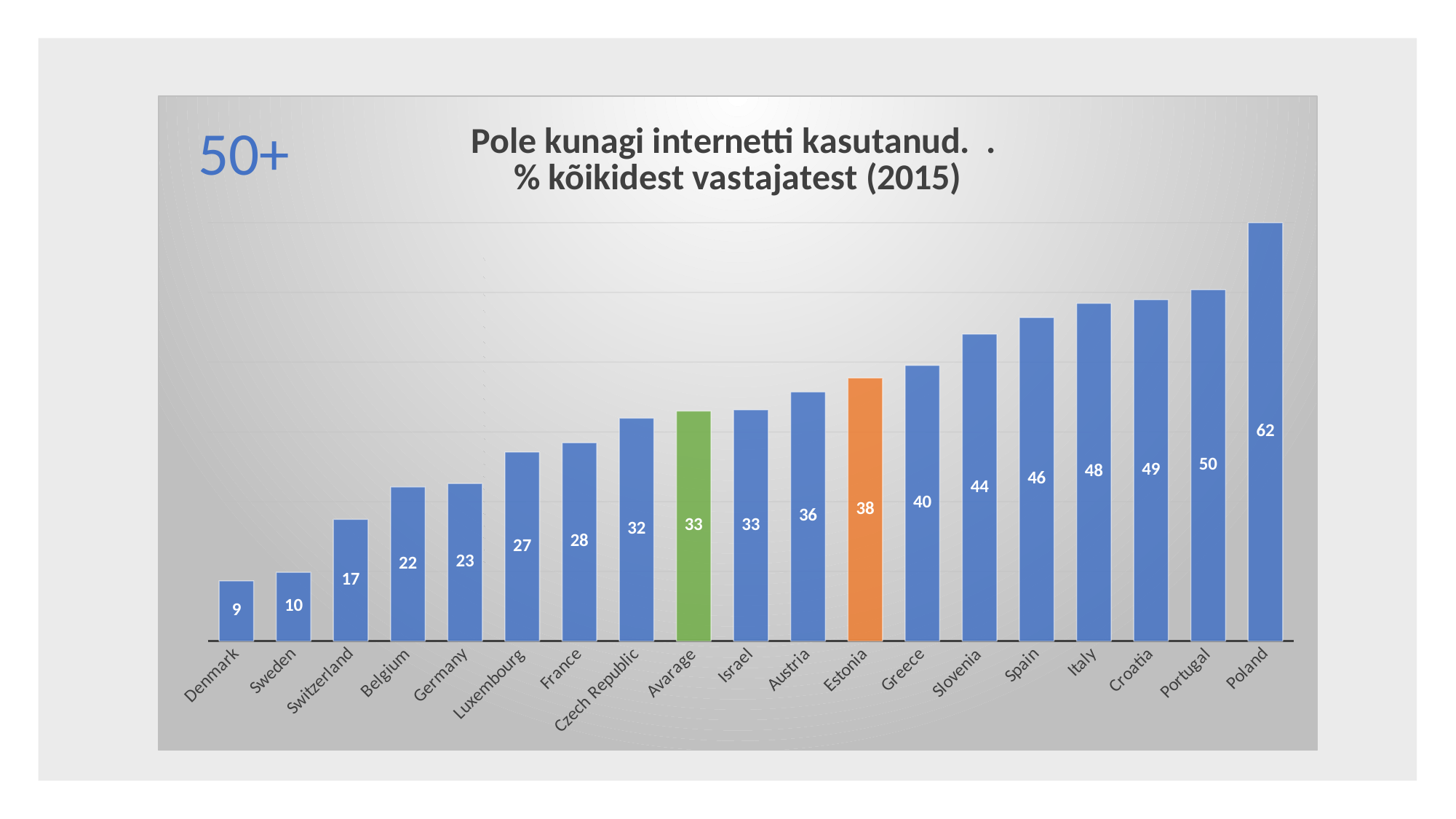
Which country has the lowest value? Denmark How many bars are shown in the chart? 19 What is the value for Avarage? 33 Which bar is coloured orange? Estonia What is the value for Estonia? 38 Which country has the highest value? Poland What is the difference between the values for Estonia and Avarage? 5 What is the difference between the values for Poland and Portugal? 12 What kind of chart is shown on the slide? Bar chart What is the value for Luxembourg? 27 What is the value for Poland? 62 Which has a larger value, Greece or Austria? Greece